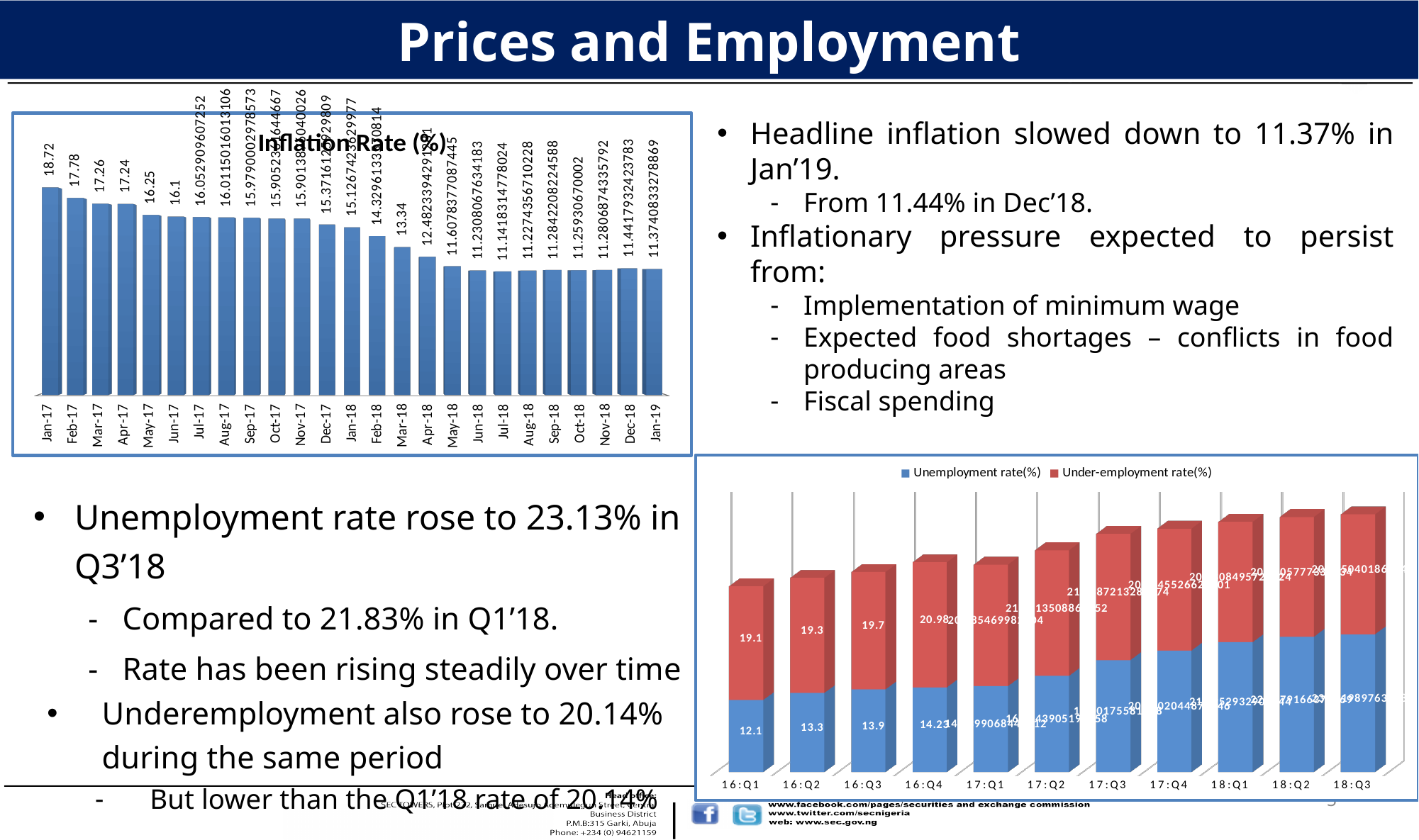
In the Inflation Rate (%) chart, what is the value for Mar-18? 13.34 How many months are plotted in the Inflation Rate (%) chart? 25 In the Inflation Rate (%) chart, do the values generally rise or fall from Jan-17 to Jan-19? fall How many series does the legend of the bottom-right stacked bar chart list? 2 In the bottom-right stacked bar chart, what is the Unemployment rate(%) for 16:Q1? 12.1 How many quarters are plotted in the bottom-right stacked bar chart? 11 In the Inflation Rate (%) chart, which is larger, the value for Mar-17 or the value for Mar-18? Mar-17 In the Inflation Rate (%) chart, which month has the highest inflation rate? Jan-17 In the Inflation Rate (%) chart, what is the difference between the Jan-17 and Feb-17 values? 0.94 In the Inflation Rate (%) chart, what is the value for Jan-17? 18.72 In the bottom-right stacked bar chart, what is the total of the 16:Q2 bar (Unemployment rate plus Under-employment rate)? 32.6 What kind of chart is the Inflation Rate (%) chart? bar chart